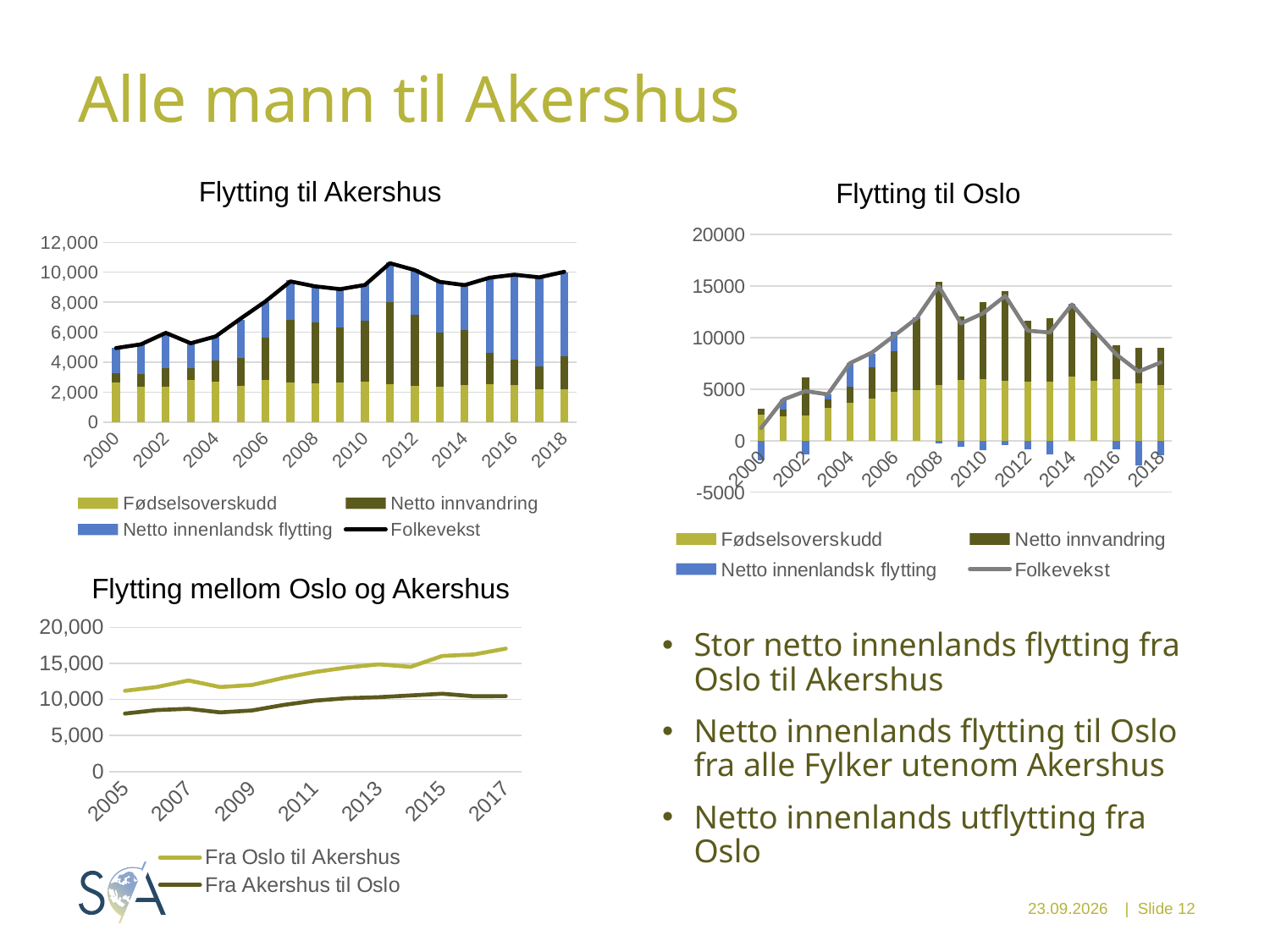
In the 'Flytting til Oslo' chart, is the 'Folkevekst' value in 2008 greater or less than 10000? greater In the 'Flytting mellom Oslo og Akershus' chart, is the value for 'Fra Oslo til Akershus' in 2017 greater or less than 15,000? greater In the 'Flytting til Akershus' chart, is the 'Folkevekst' value in 2000 greater or less than 6,000? less In the 'Flytting mellom Oslo og Akershus' chart, does the 'Fra Oslo til Akershus' line generally rise or fall from 2005 to 2017? rise In the 'Flytting mellom Oslo og Akershus' chart, which series is higher in 2017, 'Fra Oslo til Akershus' or 'Fra Akershus til Oslo'? Fra Oslo til Akershus In the 'Flytting til Oslo' chart, which series is shown as a line rather than bars? Folkevekst In the 'Flytting mellom Oslo og Akershus' chart, what kind of chart is it? line chart In the 'Flytting til Akershus' chart, how many series does the legend list? 4 In the 'Flytting mellom Oslo og Akershus' chart, how many series does the legend list? 2